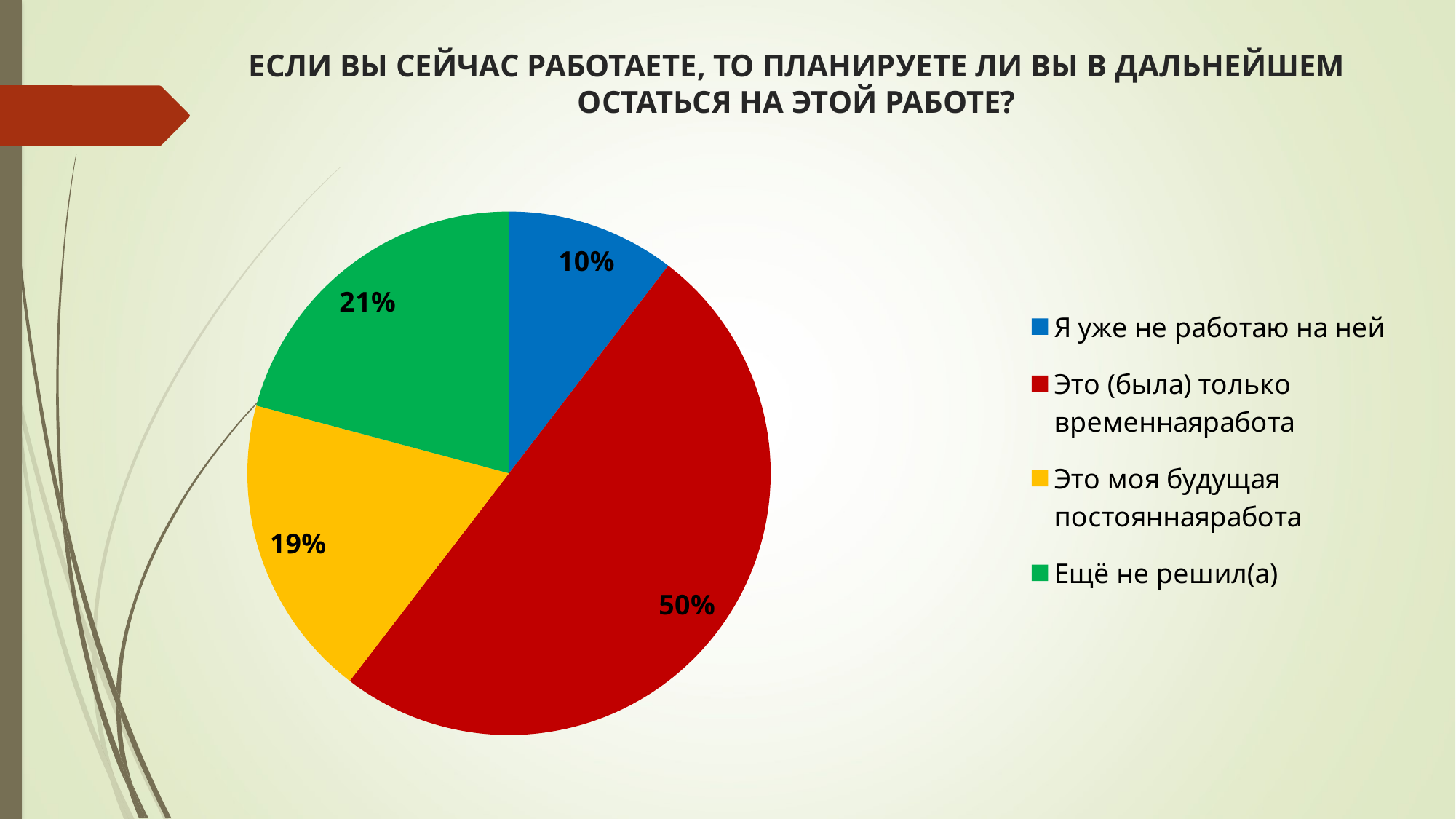
How many slices does the pie chart have? 4 Which is larger: the slice for "Ещё не решил(а)" or the slice for "Это моя будущая постоянная работа"? Ещё не решил(а) What colour is the slice for "Ещё не решил(а)"? green What share of the pie is labelled "Я уже не работаю на ней"? 10% Which category has the smallest slice of the pie? Я уже не работаю на ней How many entries does the legend list? 4 What share of the pie is labelled "Это (была) только временная работа"? 50% What kind of chart is shown on the slide? pie chart What share of the pie is labelled "Это моя будущая постоянная работа"? 19% Which category has the largest slice of the pie? Это (была) только временная работа What is the difference in percentage points between "Это (была) только временная работа" and "Ещё не решил(а)"? 29